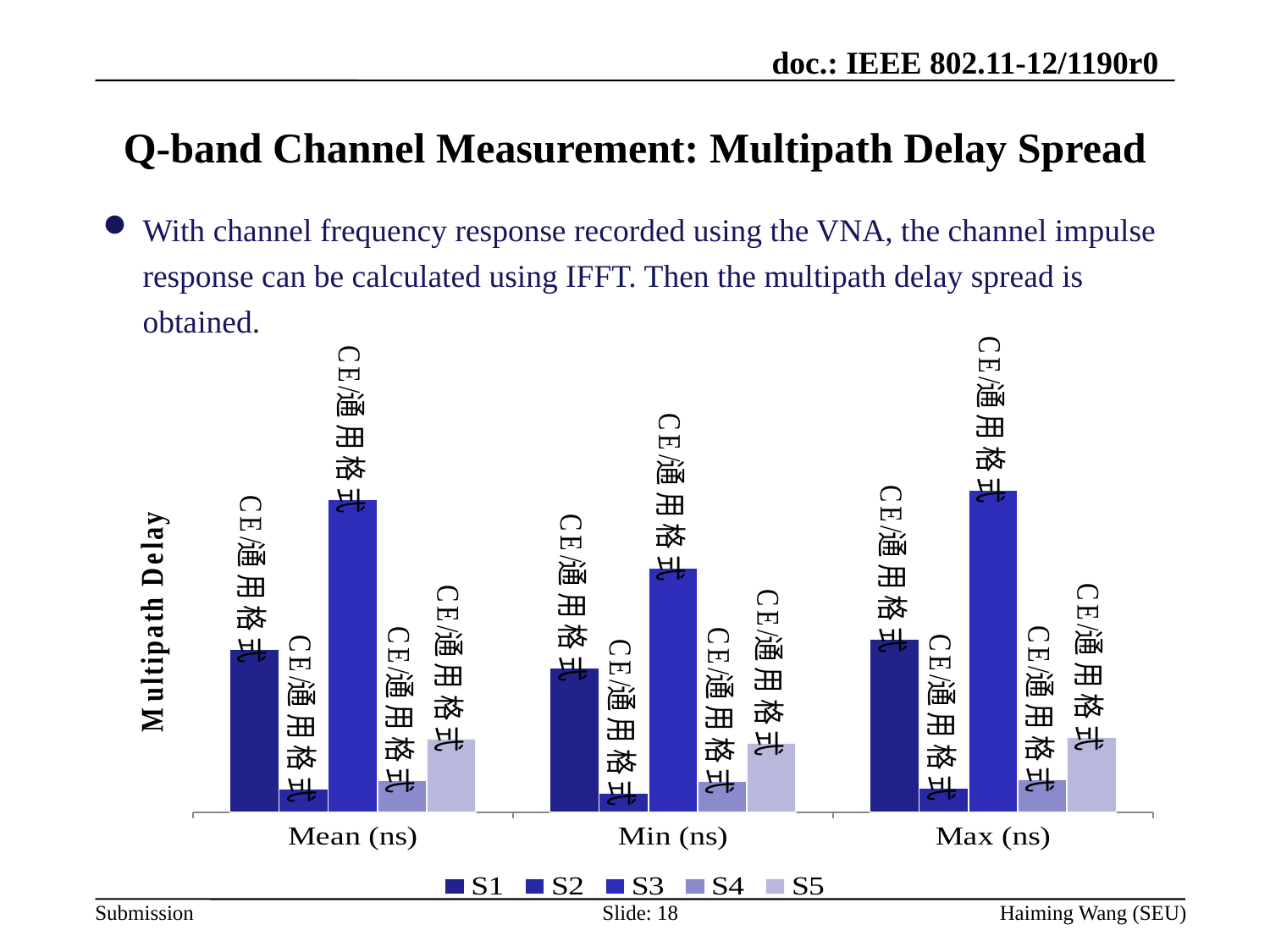
Which series has the lowest bar in the Min (ns) group? S2 What kind of chart is shown on the slide? bar chart How many categories are shown on the x axis of the chart? 3 Which series has the lowest bar in the Max (ns) group? S2 In the Mean (ns) group, which bar is taller, S1 or S5? S1 How many series does the chart legend list? 5 Which series has the highest bar in the Max (ns) group? S3 Which series has the highest bar in the Mean (ns) group? S3 In the Min (ns) group, which bar is taller, S4 or S5? S5 What are the entries listed in the chart legend? S1, S2, S3, S4, S5 Across the three groups, in which category is the S3 bar tallest? Max (ns) What is the label on the vertical axis of the chart? Multipath Delay